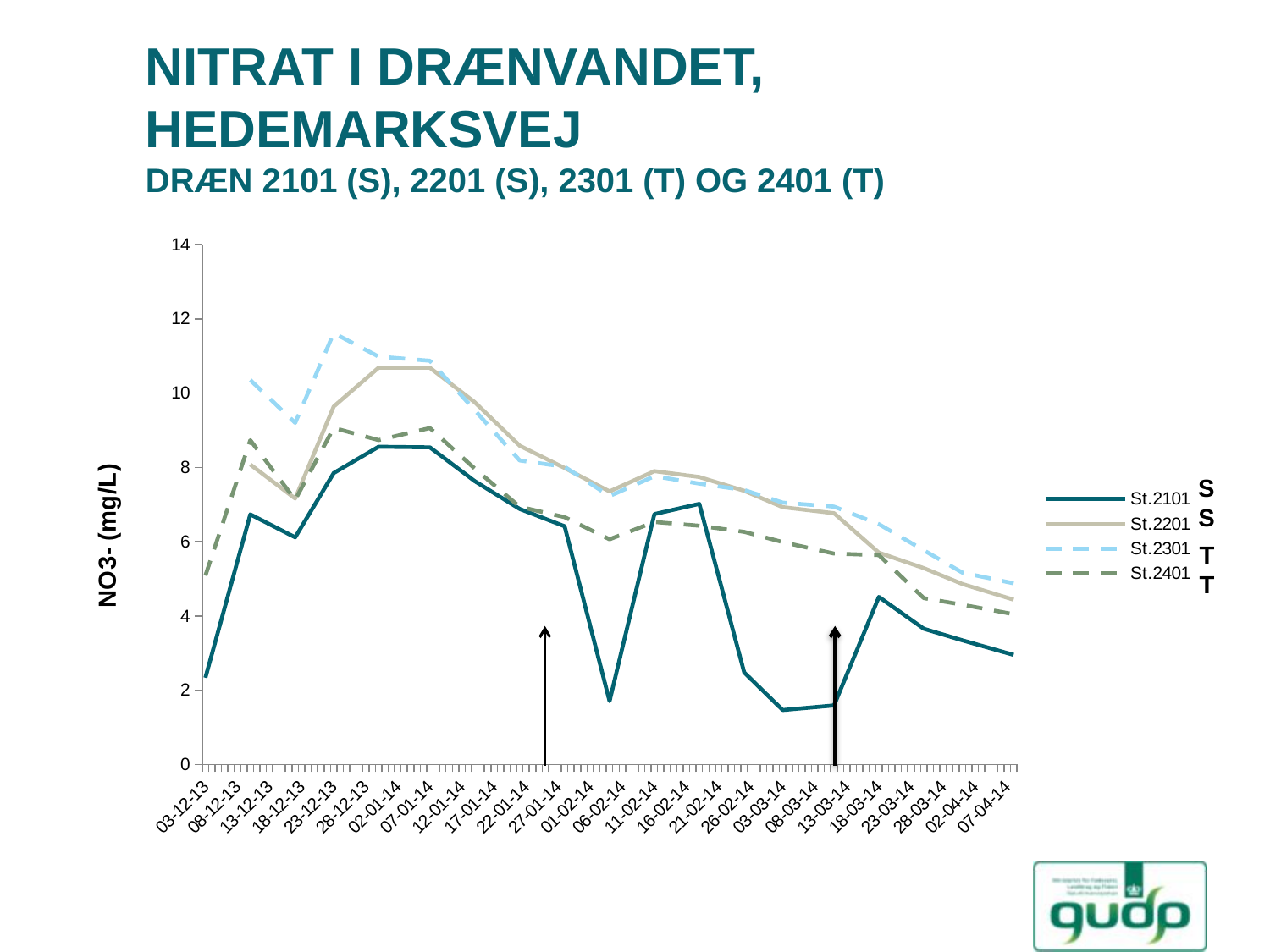
Which series has the lowest value on the chart? St.2101 What is the highest value shown on the y axis? 14 Is the value for St.2101 at 06-02-14 greater or less than 2? less How many series does the legend list? 4 Does the St.2301 series rise or fall from 23-12-13 to 07-04-14? fall Is the value for St.2401 at 07-04-14 greater or less than 6? less At 07-04-14, which is larger: St.2301 or St.2101? St.2301 What kind of chart is shown on the slide? line chart Which series reaches the highest value on the chart? St.2301 Is the value for St.2201 at 02-01-14 greater or less than 10? greater What is the label on the y axis? NO3- (mg/L)